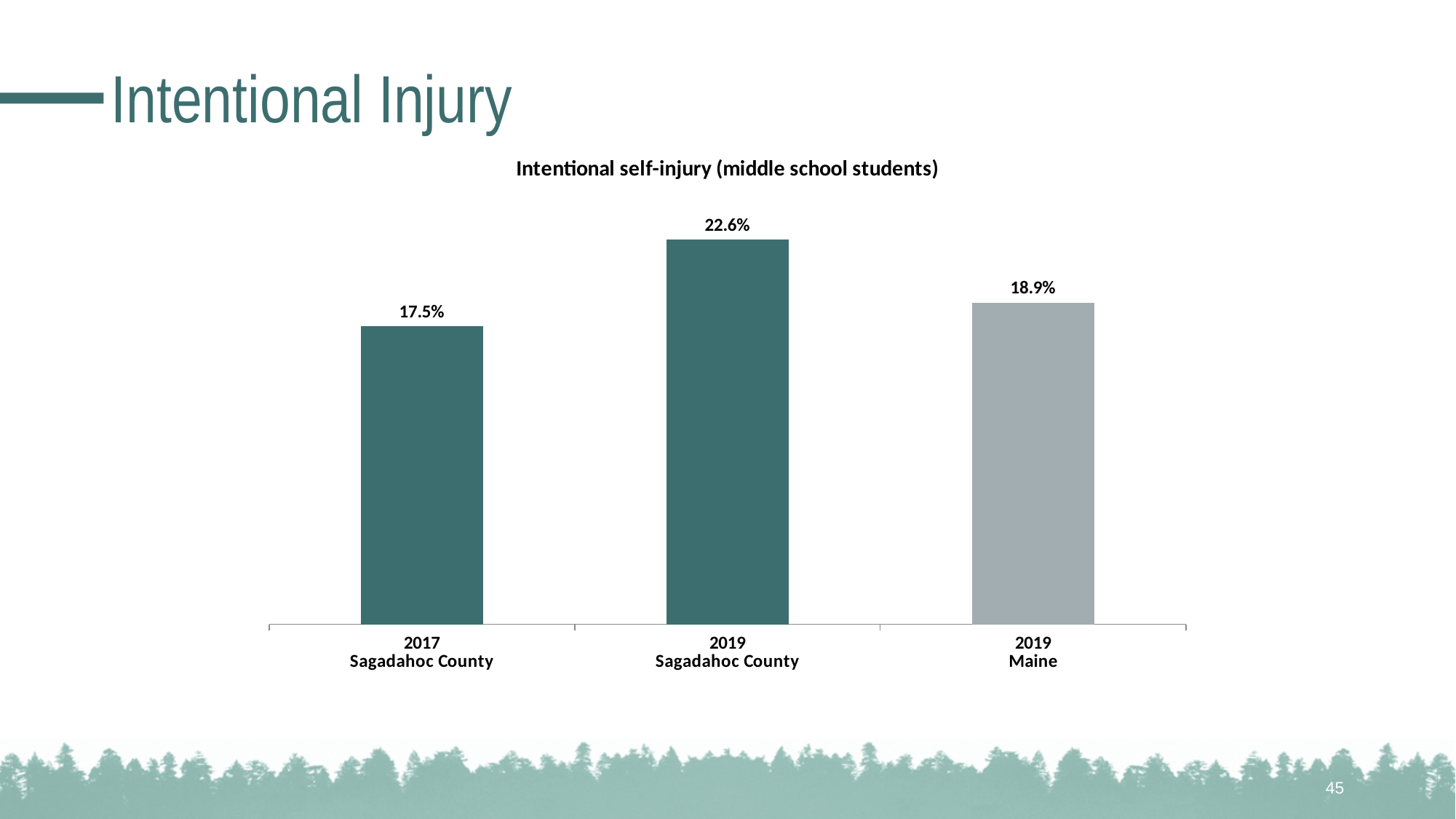
Which category has the lowest value? 2017 Sagadahoc County What is the difference between the 2019 Sagadahoc County value and the 2019 Maine value? 3.7% What is the value for 2017 Sagadahoc County? 17.5% Which is larger, the value for 2019 Sagadahoc County or the value for 2019 Maine? 2019 Sagadahoc County What is the value for 2019 Sagadahoc County? 22.6% How many bars are shown in the chart? 3 What is the difference between the 2019 Sagadahoc County value and the 2017 Sagadahoc County value? 5.1% What is the title of the chart? Intentional self-injury (middle school students) What is the value for 2019 Maine? 18.9% Did the Sagadahoc County value rise or fall from 2017 to 2019? Rise Which category has the highest value? 2019 Sagadahoc County What kind of chart is shown on the slide? Bar chart